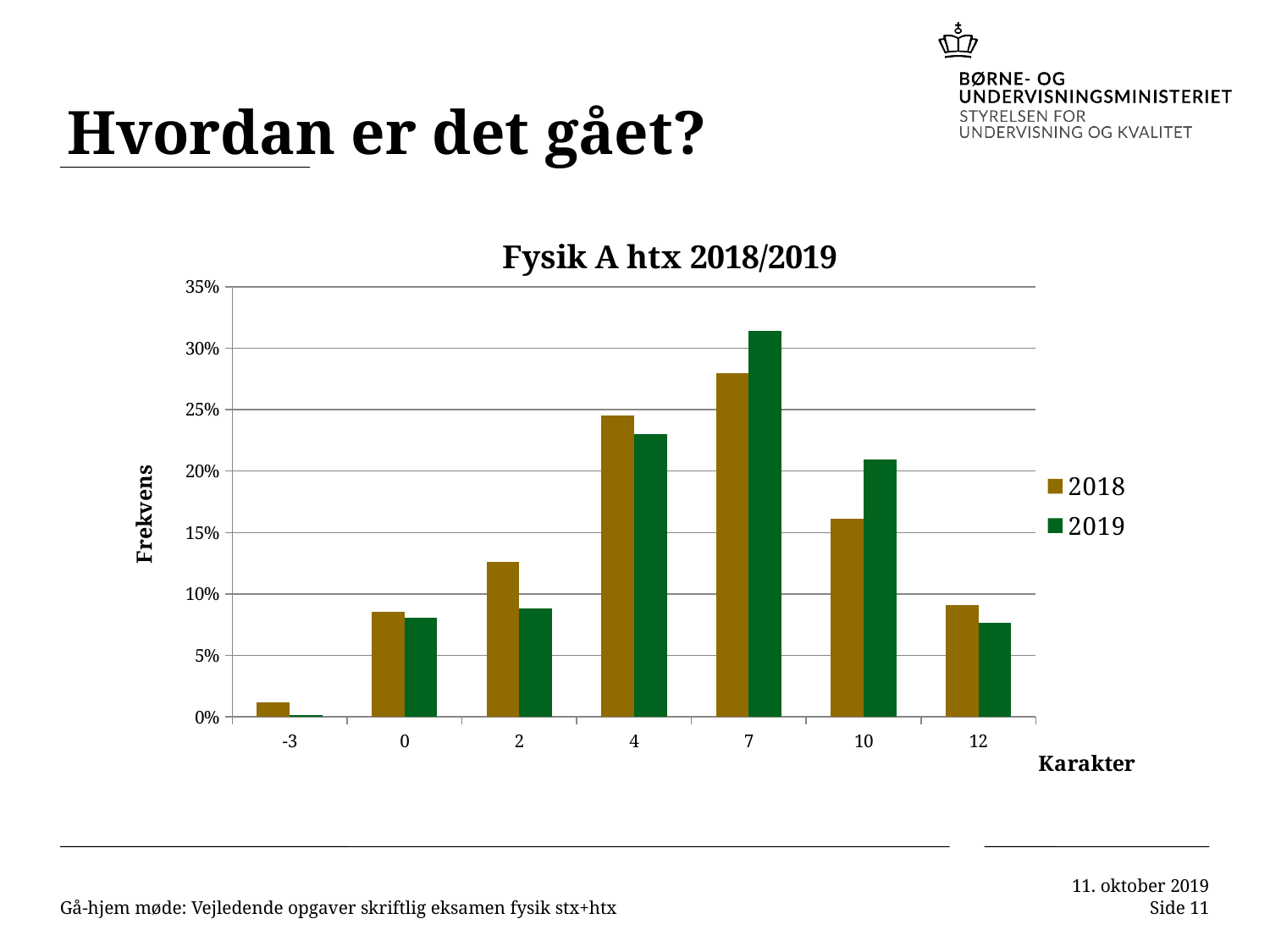
Which grade has the lowest frequency for 2018? -3 For grade 10, which series has the larger value, 2018 or 2019? 2019 For grade 2, which series has the larger value, 2018 or 2019? 2018 What kind of chart is shown on the slide? bar chart Is the 2019 value for grade 2 greater or less than 10%? less Is the 2019 value for grade 10 greater or less than 20%? greater Is the 2019 value for grade 7 greater or less than 30%? greater What is the title of the chart? Fysik A htx 2018/2019 How many grade categories are shown on the x axis? 7 Which grade has the highest frequency for 2019? 7 How many series does the legend list? 2